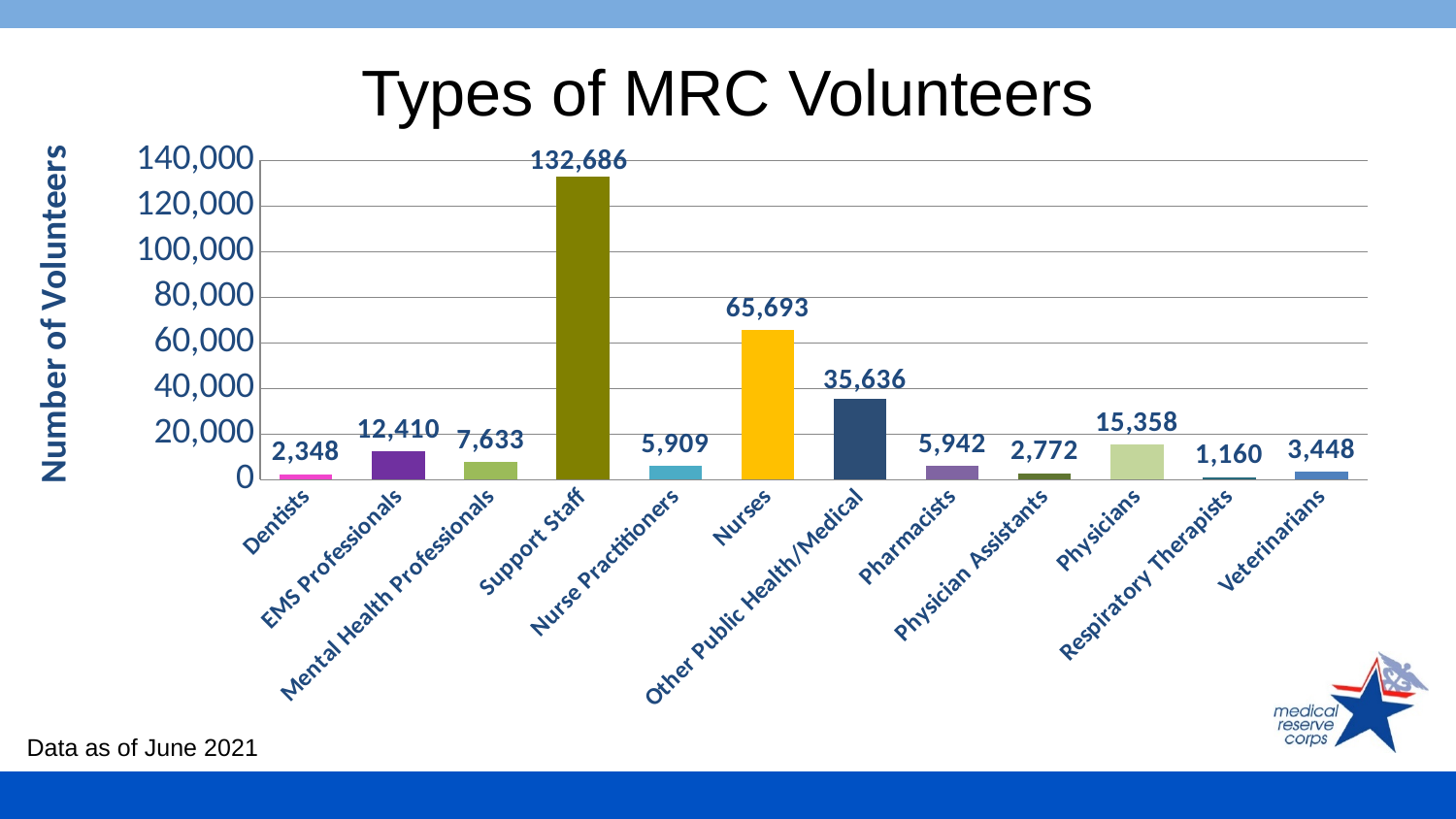
Is the value for Other Public Health/Medical greater or less than 40,000? less Which type of volunteer has the lowest number? Respiratory Therapists What is the number of Nurses shown on the chart? 65,693 How many more Support Staff are there than Nurses? 66,993 How many volunteers are Support Staff? 132,686 Which type of volunteer has the highest number? Support Staff Which is larger, the number of Physicians or the number of EMS Professionals? Physicians How many Respiratory Therapists are shown? 1,160 How many volunteer types are shown on the chart? 12 What is the difference between the number of Nurses and the number of Other Public Health/Medical volunteers? 30,057 What kind of chart is shown on the slide? Bar chart What is the value for Physicians? 15,358